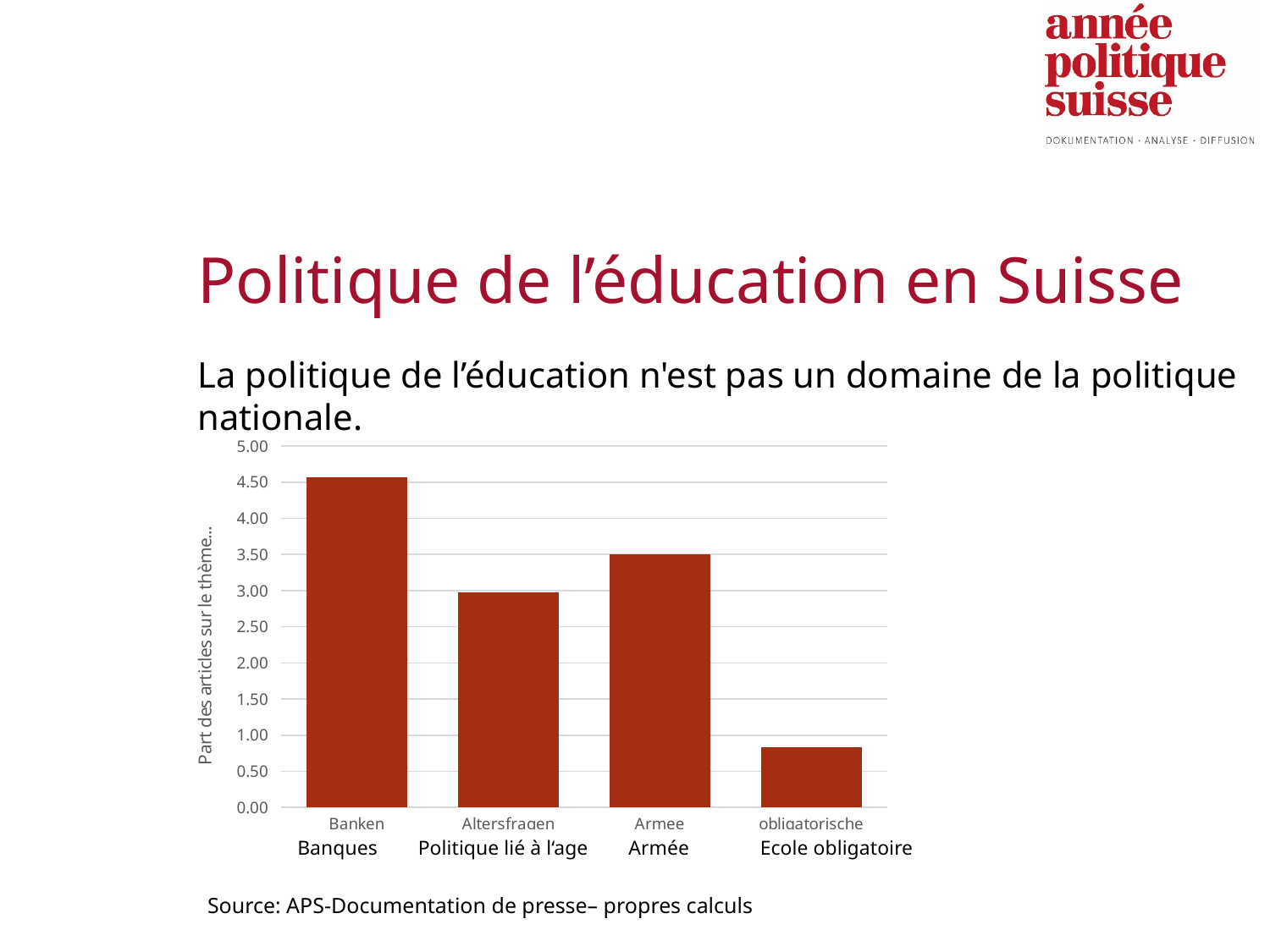
Which is larger, the value for Banques or the value for Armée? Banques What kind of chart is shown on the slide? bar chart What source is cited below the chart? APS-Documentation de presse– propres calculs What is the highest value shown on the y axis of the chart? 5.00 Which category has the lowest bar in the chart? Ecole obligatoire Which is larger, the value for Armée or the value for Politique lié à l'age? Armée How many categories are plotted in the chart? 4 Is the value for Ecole obligatoire greater or less than 1.00? less Which category has the highest bar in the chart? Banques Is the value for Politique lié à l'age greater or less than 2.50? greater Is the value for Armée greater or less than 3.00? greater